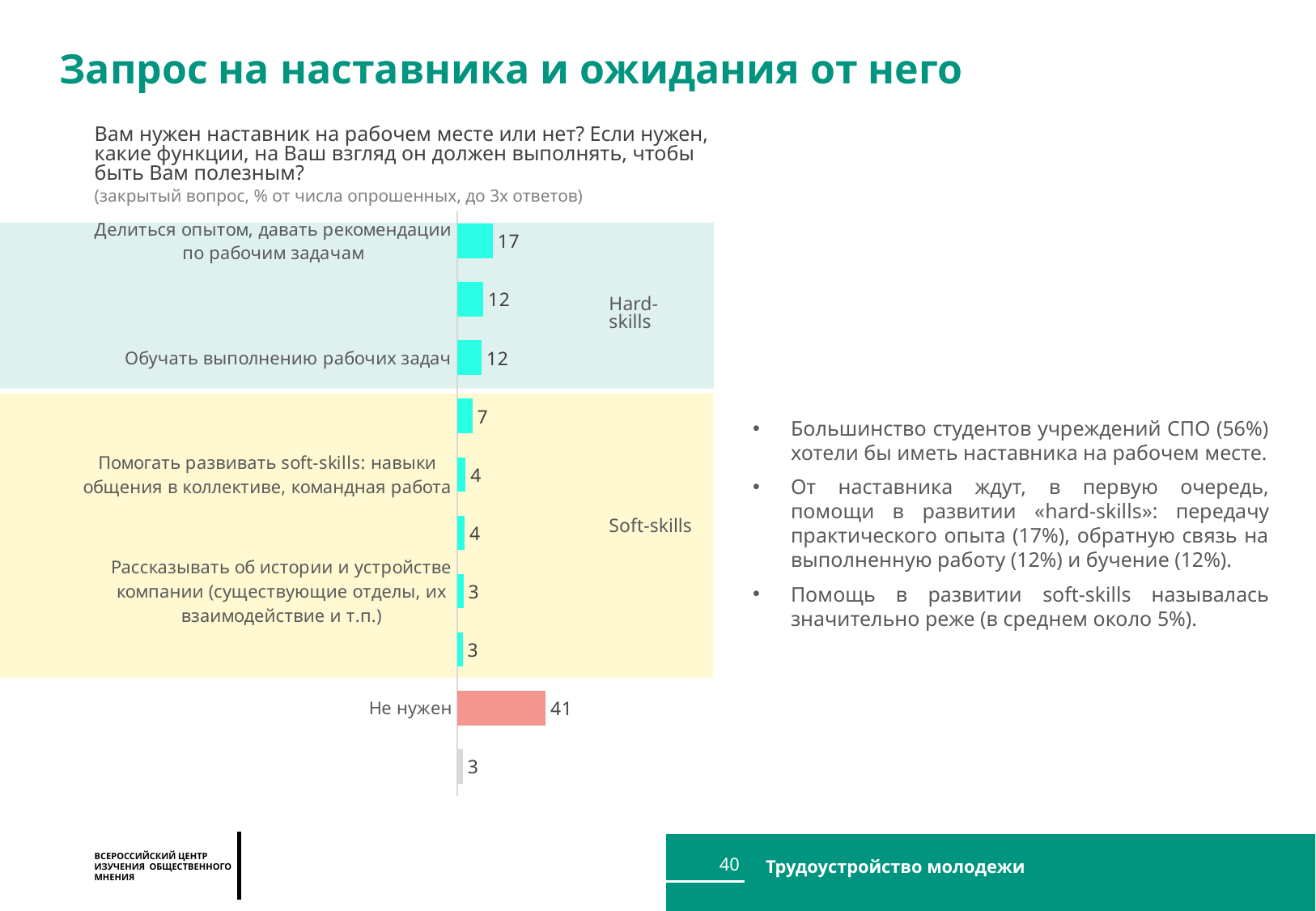
What is the difference between the value for «Делиться опытом, давать рекомендации по рабочим задачам» and the value for «Обучать выполнению рабочих задач»? 5 What value is shown for «Помогать развивать soft-skills: навыки общения в коллективе, командная работа»? 4 What kind of chart is shown on the slide? Bar chart Which is larger: the value for «Делиться опытом, давать рекомендации по рабочим задачам» or the value for «Обучать выполнению рабочих задач»? Делиться опытом, давать рекомендации по рабочим задачам What value is shown for «Рассказывать об истории и устройстве компании (существующие отделы, их взаимодействие и т.п.)»? 3 What value is shown for «Делиться опытом, давать рекомендации по рабочим задачам»? 17 What is the difference between the value for «Не нужен» and the value for «Делиться опытом, давать рекомендации по рабочим задачам»? 24 What value is shown for «Не нужен»? 41 Which two group labels are shown on the shaded areas of the chart? Hard-skills and Soft-skills Which category has the highest value in the chart? Не нужен What value is shown for «Обучать выполнению рабочих задач»? 12 How many bars are plotted in the chart? 10